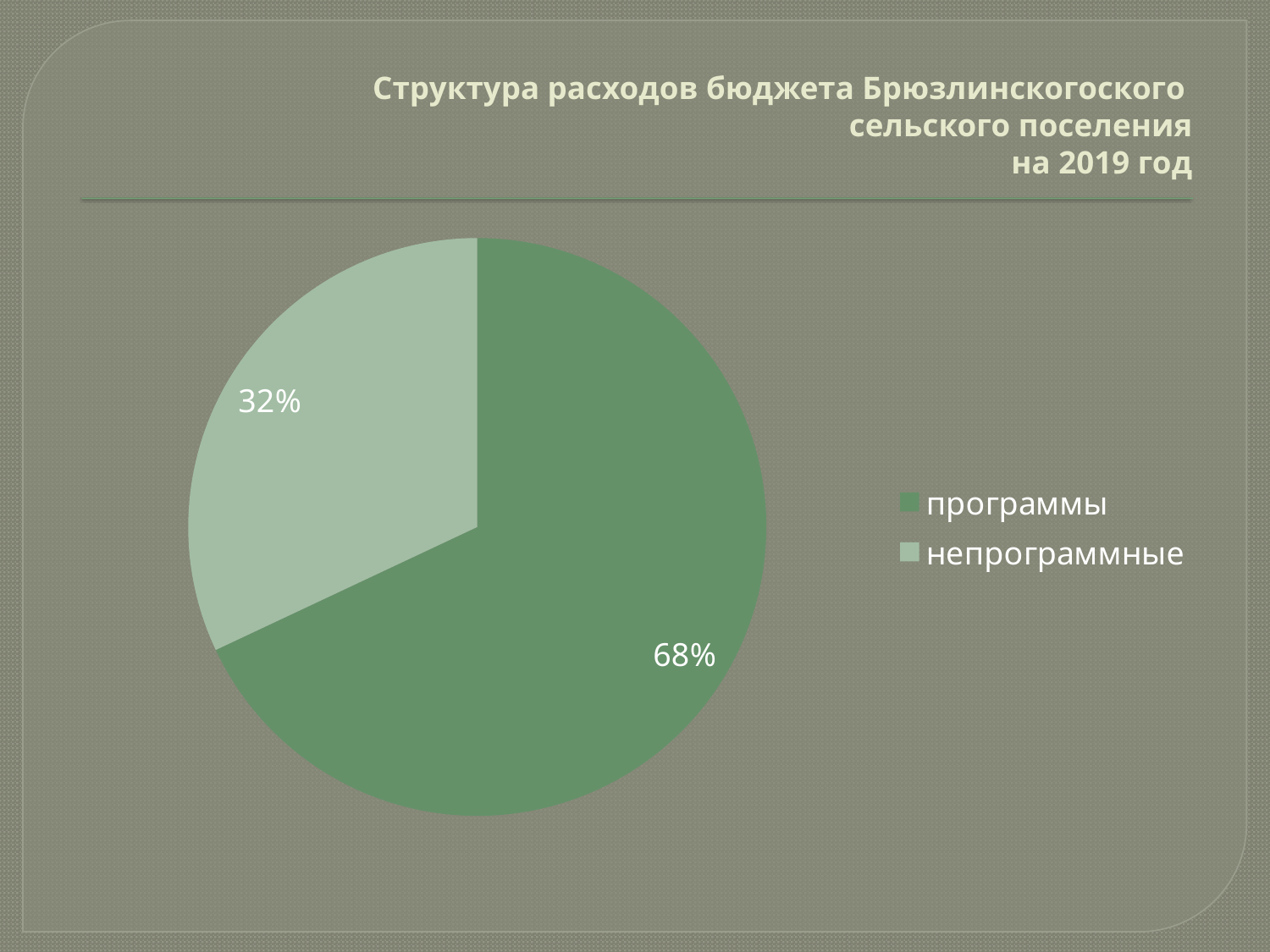
What is the title of the chart on the slide? Структура расходов бюджета Брюзлинскогоского сельского поселения на 2019 год How many slices does the pie chart have? 2 What kind of chart is shown on the slide? pie chart Is the share for "непрограммные" greater or less than 50%? less How many entries does the legend list? 2 Which slice is the largest in the pie chart? программы Which legend entry is shown in the lighter green colour? непрограммные Which slice is the smallest in the pie chart? непрограммные Which is larger: the "программы" slice or the "непрограммные" slice? программы What is the difference in percentage points between the "программы" and "непрограммные" slices? 36 What share of the pie does the "непрограммные" slice represent? 32% What share of the pie does the "программы" slice represent? 68%